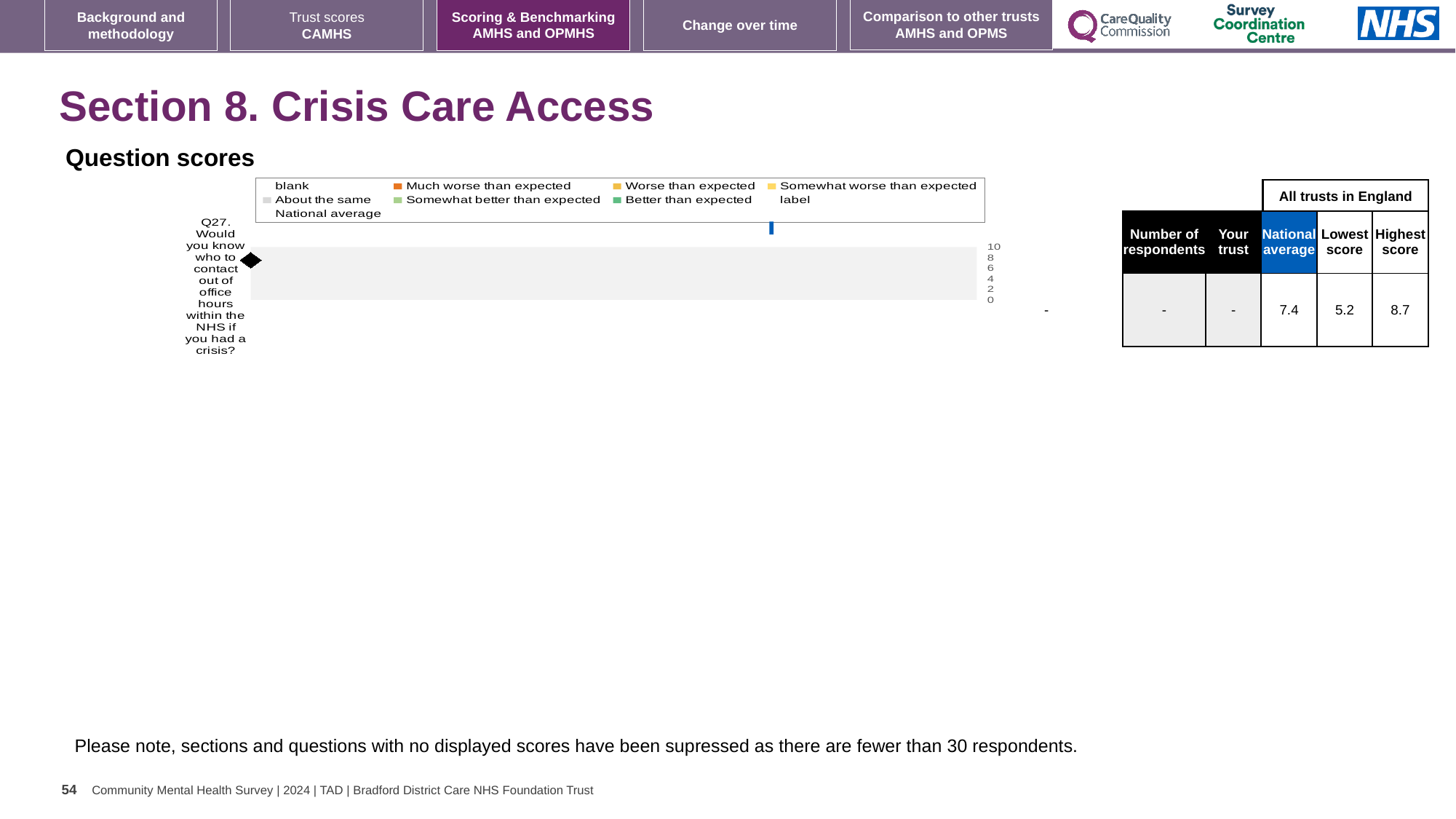
In the table next to the chart, what is the difference between the Highest score and the Lowest score for Q27? 3.5 In the table next to the chart, what is the Lowest score for Q27? 5.2 Which question is shown on the chart's y axis? Q27. Would you know who to contact out of office hours within the NHS if you had a crisis? How many question categories are listed on the y axis of the chart? 1 In the table next to the chart, is the National average for Q27 greater or less than the Lowest score? greater In the table next to the chart, what is shown for 'Your trust' for Q27? - What kind of chart is shown under 'Question scores'? bar chart What is the highest value shown on the chart's numeric axis? 10 In the table next to the chart, what is the Highest score for Q27? 8.7 In the table next to the chart, what is the National average score for Q27? 7.4